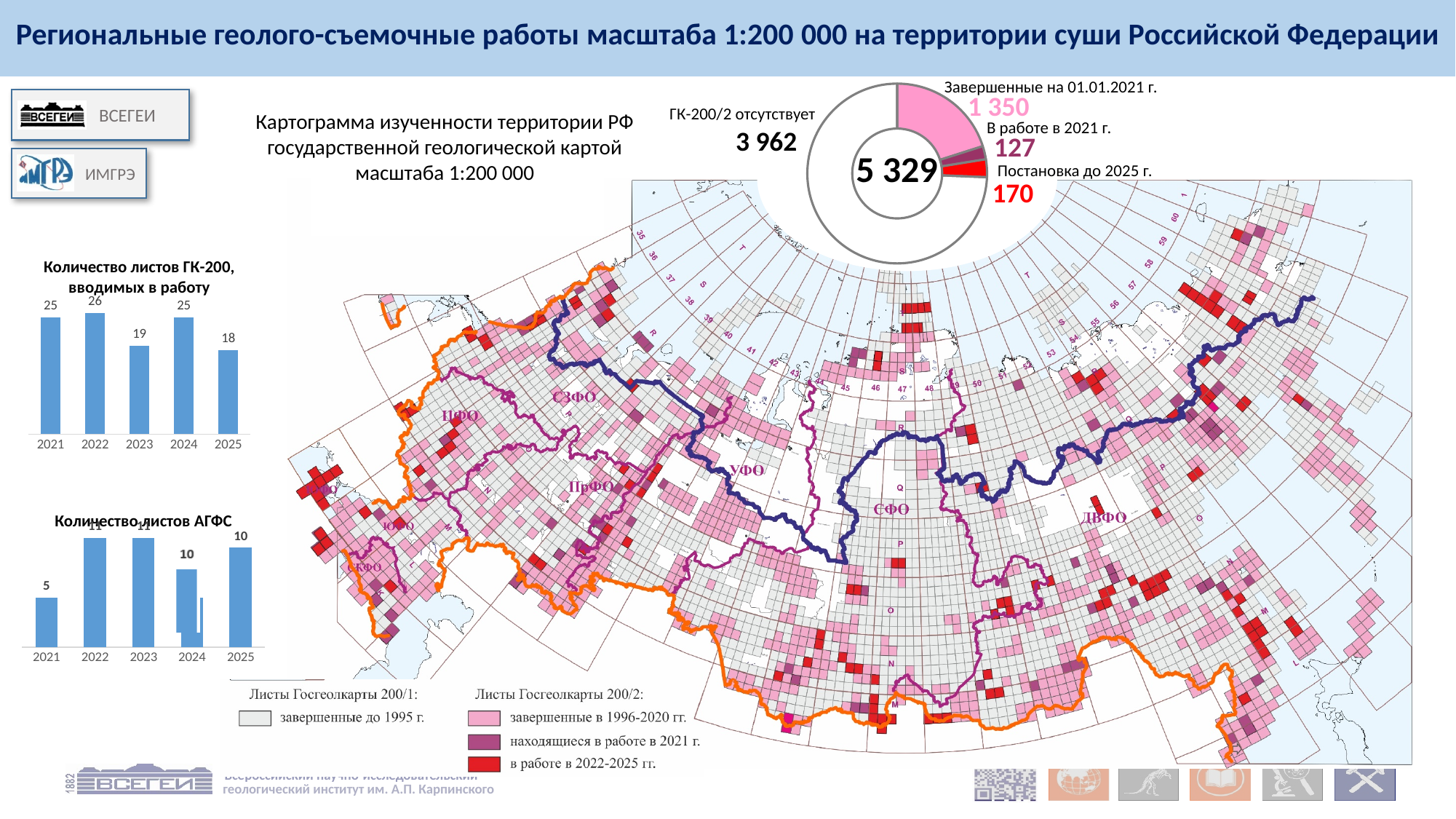
In the donut chart at the top of the slide, what total is shown in the centre? 5 329 In the chart 'Количество листов АГФС', what is the value for 2025? 10 In the chart 'Количество листов АГФС', what is the value for 2021? 5 In the chart 'Количество листов ГК-200, вводимых в работу', how many years are shown on the x axis? 5 In the chart 'Количество листов ГК-200, вводимых в работу', which year has the highest value? 2022 In the donut chart at the top of the slide, what is the value for 'Завершенные на 01.01.2021 г.'? 1 350 In the chart 'Количество листов ГК-200, вводимых в работу', what is the difference between the values for 2022 and 2023? 7 In the chart 'Количество листов АГФС', which year has the lowest value? 2021 In the chart 'Количество листов ГК-200, вводимых в работу', what is the value for 2022? 26 In the chart 'Количество листов ГК-200, вводимых в работу', which year has the lowest value? 2025 What type of chart is 'Количество листов АГФС'? bar chart In the chart 'Количество листов ГК-200, вводимых в работу', what is the value for 2025? 18